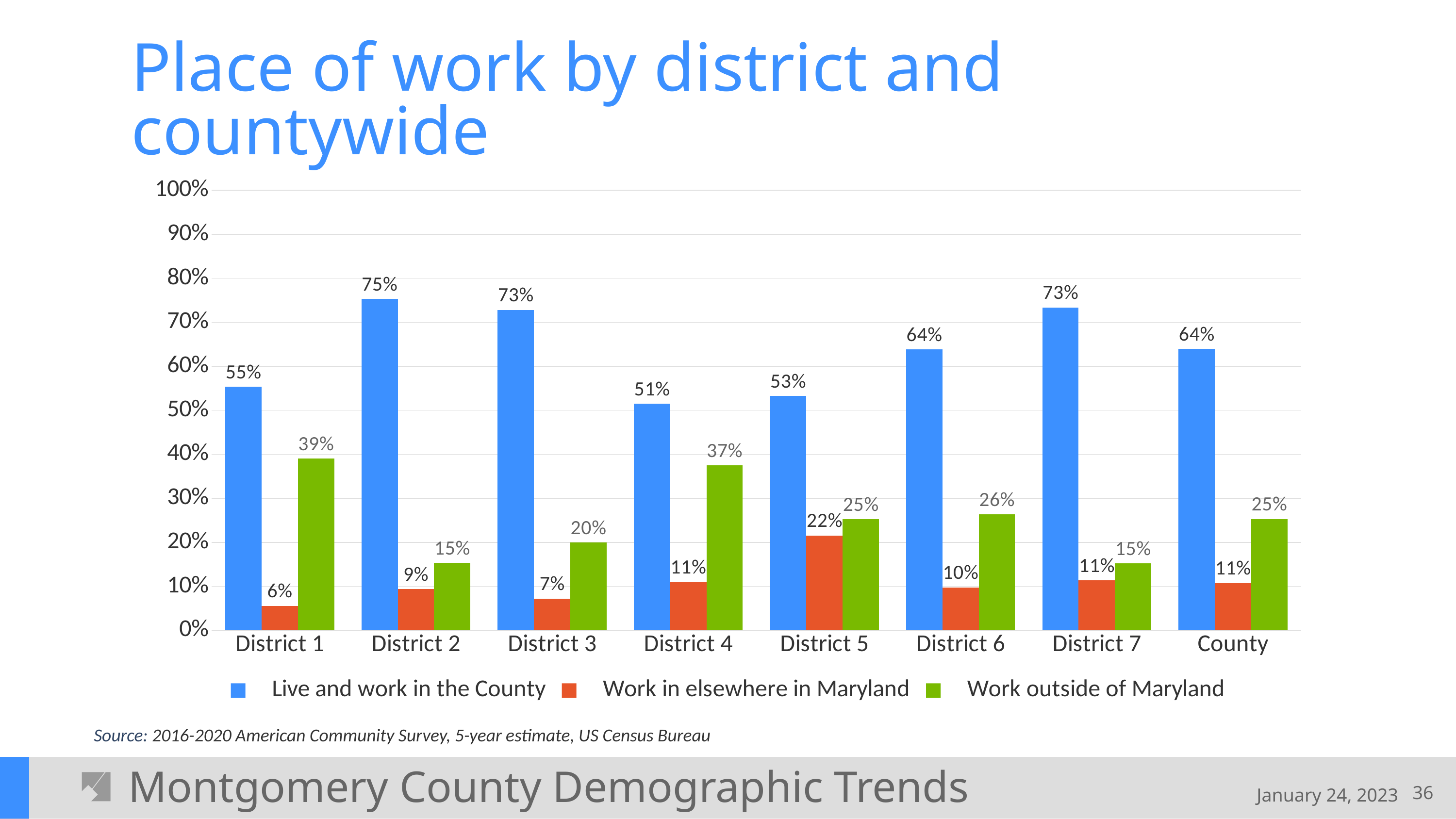
What is the value for 'Live and work in the County' in District 2? 75% Which is larger: 'Live and work in the County' in District 4 or in District 6? District 6 What kind of chart is shown on the slide? Bar chart What is the difference between the 'Work outside of Maryland' values for District 1 and District 2? 24% Which category has the lowest value for 'Work in elsewhere in Maryland'? District 1 How many series does the legend list? 3 Which category has the highest value for 'Live and work in the County'? District 2 What is the value for 'Work outside of Maryland' for County? 25% What colour are the bars for 'Work outside of Maryland'? Green What is the value for 'Work outside of Maryland' in District 4? 37% What is the value for 'Work in elsewhere in Maryland' in District 5? 22% How many categories are shown on the x axis? 8